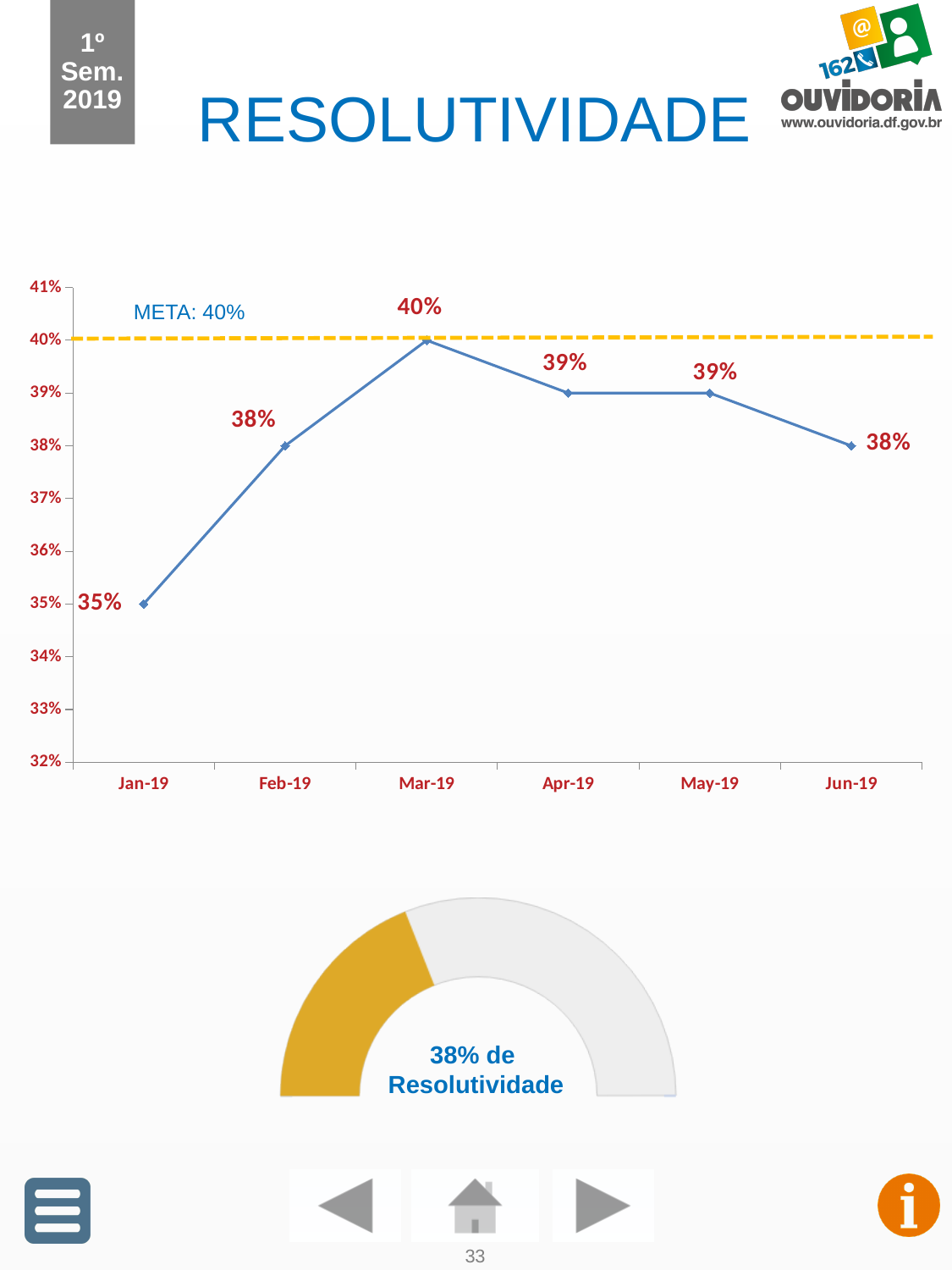
What percentage of Resolutividade does the gauge chart at the bottom of the slide show? 38% In the line chart, how many months are plotted on the x axis? 6 In the line chart, what target value does the dashed META line mark? 40% In the line chart, which month has the lowest value? Jan-19 In the line chart, what is the value for Jun-19? 38% In the line chart, what is the value for Mar-19? 40% What kind of chart is the top chart on the slide? Line chart In the line chart, which is larger, the value for Feb-19 or the value for Apr-19? Apr-19 In the line chart, what is the value for Jan-19? 35% In the line chart, what is the difference between the values for Mar-19 and Jan-19? 5% In the line chart, which month has the highest value? Mar-19 In the line chart, do the values rise or fall from Jan-19 to Mar-19? Rise